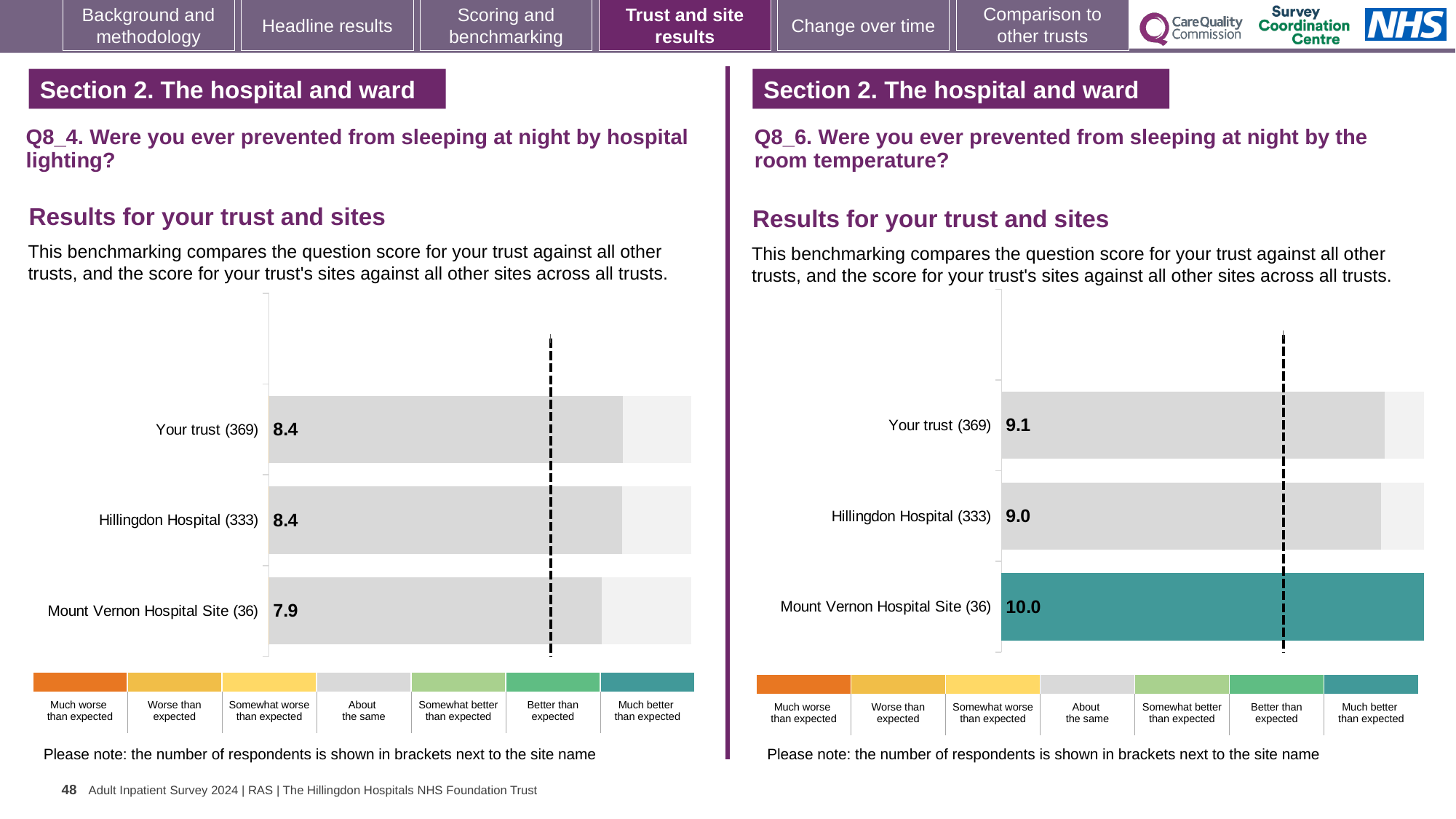
In the Q8_6 room temperature chart, what is the score for Hillingdon Hospital (333)? 9.0 In the Q8_6 room temperature chart, which row has the highest score? Mount Vernon Hospital Site (36) In the Q8_4 hospital lighting chart, what is the score for Mount Vernon Hospital Site (36)? 7.9 In the Q8_4 hospital lighting chart, what is the difference between the Your trust score and the Mount Vernon Hospital Site score? 0.5 In the Q8_6 room temperature chart, which is larger: the score for Your trust or the score for Hillingdon Hospital? Your trust What type of chart is used for the Q8_6 room temperature results? Bar chart In the Q8_6 room temperature chart, what is the score for Mount Vernon Hospital Site (36)? 10.0 In the Q8_6 room temperature chart, which benchmark category does the teal colour of the Mount Vernon Hospital Site bar correspond to? Much better than expected How many rows (trust and sites) are plotted in the Q8_4 hospital lighting chart? 3 In the Q8_4 hospital lighting chart, what is the score for Your trust (369)? 8.4 In the Q8_4 hospital lighting chart, which site has the lowest score? Mount Vernon Hospital Site (36) In the Q8_6 room temperature chart, what is the difference between the Mount Vernon Hospital Site score and the Your trust score? 0.9